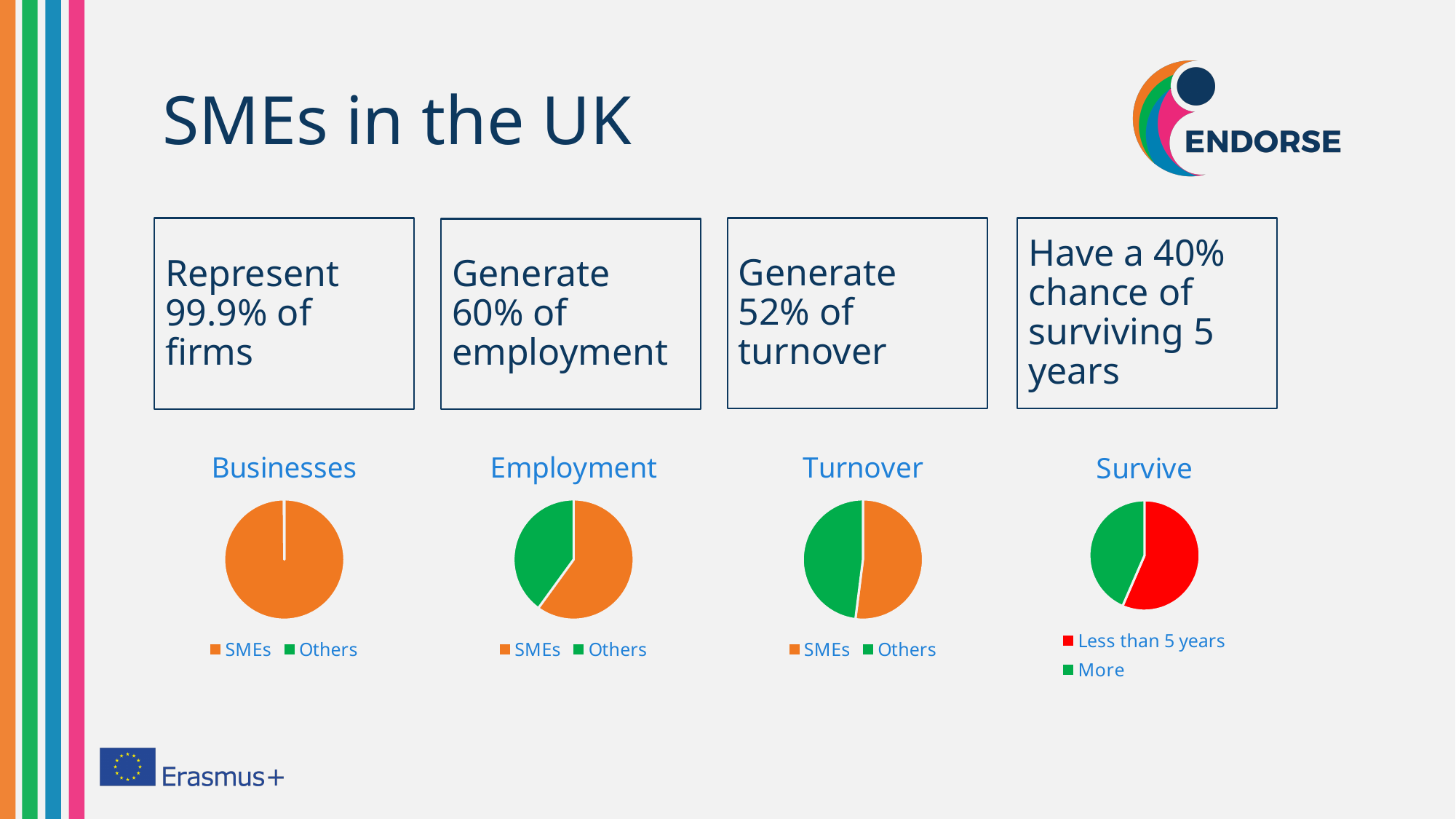
In the Businesses chart, which slice is larger, SMEs or Others? SMEs How many entries does the legend of the Turnover chart list? 2 How many entries does the legend of the Survive chart list? 2 How many pie charts are shown on the slide? 4 How many slices does the Employment pie chart have? 2 What kind of chart is the Survive chart? pie chart What are the two legend entries of the Survive chart? Less than 5 years, More In the Survive chart, which slice is larger, Less than 5 years or More? Less than 5 years What kind of chart is the Businesses chart? pie chart What colour represents SMEs in the Employment chart? orange In the Employment chart, which slice is larger, SMEs or Others? SMEs In the Businesses chart, which category has the smallest slice? Others